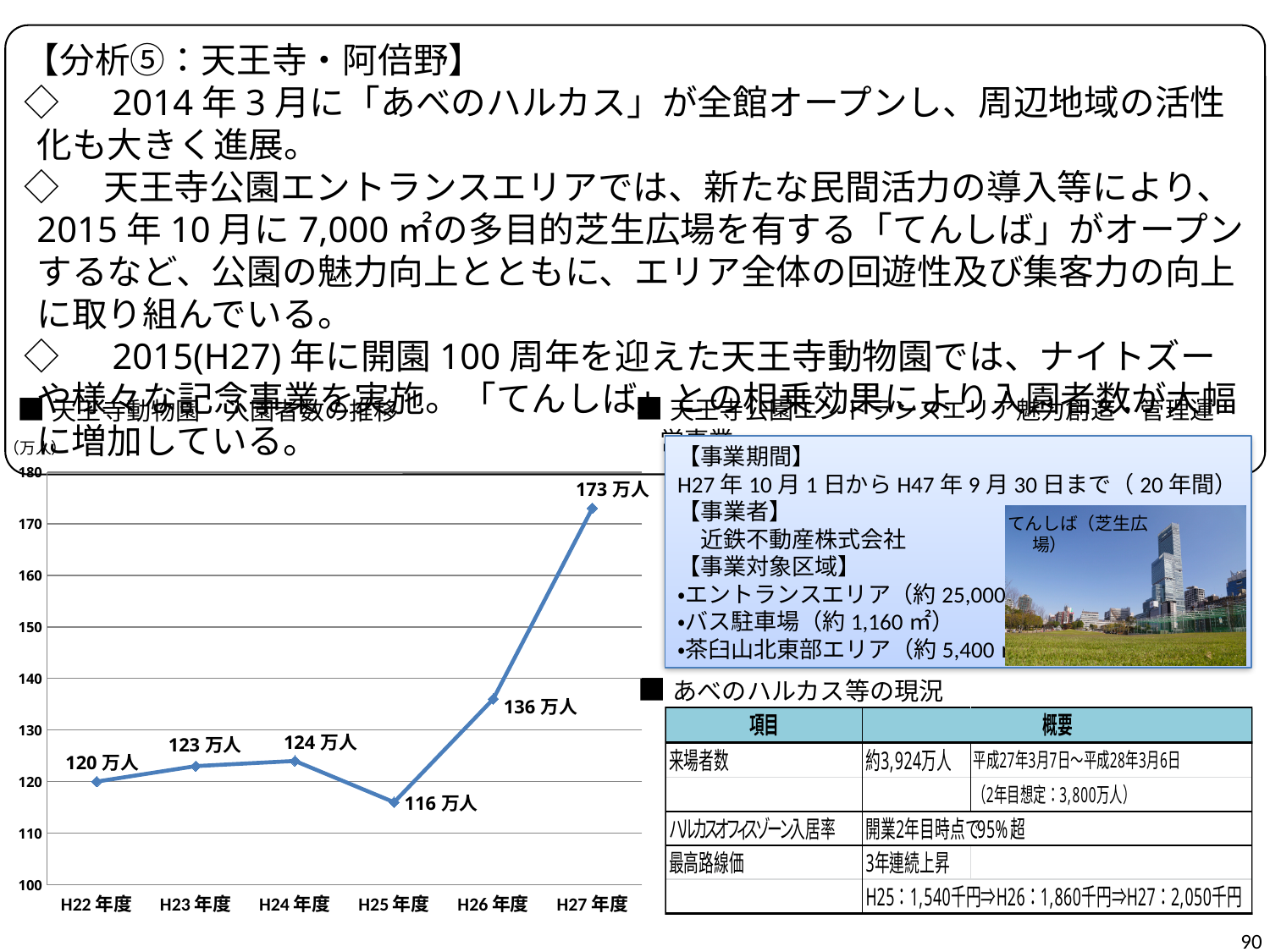
What kind of chart is shown on the left of the slide? line chart What is the value for H22年度 in the line chart? 120 万人 Which fiscal year has the highest value in the line chart? H27 年度 What is the value for H25年度 in the line chart? 116 万人 What is the difference between the values for H24年度 and H25年度 in the line chart? 8 万人 How many fiscal years are plotted in the line chart? 6 Which is larger in the line chart, the value for H23年度 or the value for H26年度? H26 年度 What is the value for H27年度 in the line chart? 173 万人 Which fiscal year has the lowest value in the line chart? H25 年度 What is the difference between the values for H27年度 and H26年度 in the line chart? 37 万人 Is the value for H26年度 in the line chart greater or less than 130? greater Does the value in the line chart rise or fall from H25年度 to H27年度? rise